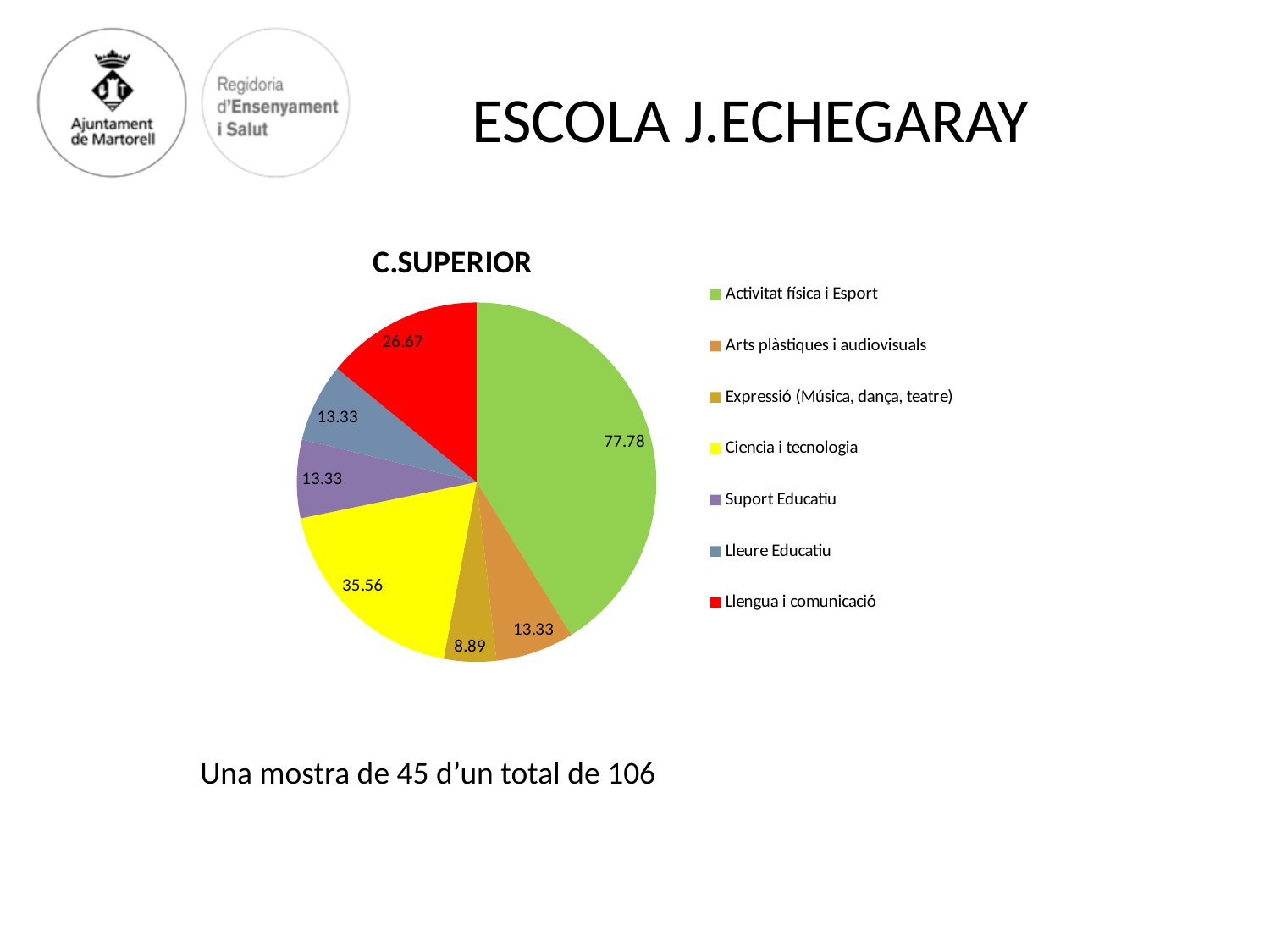
What value is shown for Llengua i comunicació? 26.67 What value is shown for Suport Educatiu? 13.33 What value is shown for Activitat física i Esport? 77.78 What is the difference between the values for Activitat física i Esport and Ciencia i tecnologia? 42.22 What is the title of the chart? C.SUPERIOR What value is shown for Expressió (Música, dança, teatre)? 8.89 Which category has the largest slice? Activitat física i Esport How many categories does the legend list? 7 Which is larger, the value for Llengua i comunicació or the value for Lleure Educatiu? Llengua i comunicació Which category has the smallest slice? Expressió (Música, dança, teatre) What value is shown for Ciencia i tecnologia? 35.56 What type of chart is shown on the slide? pie chart